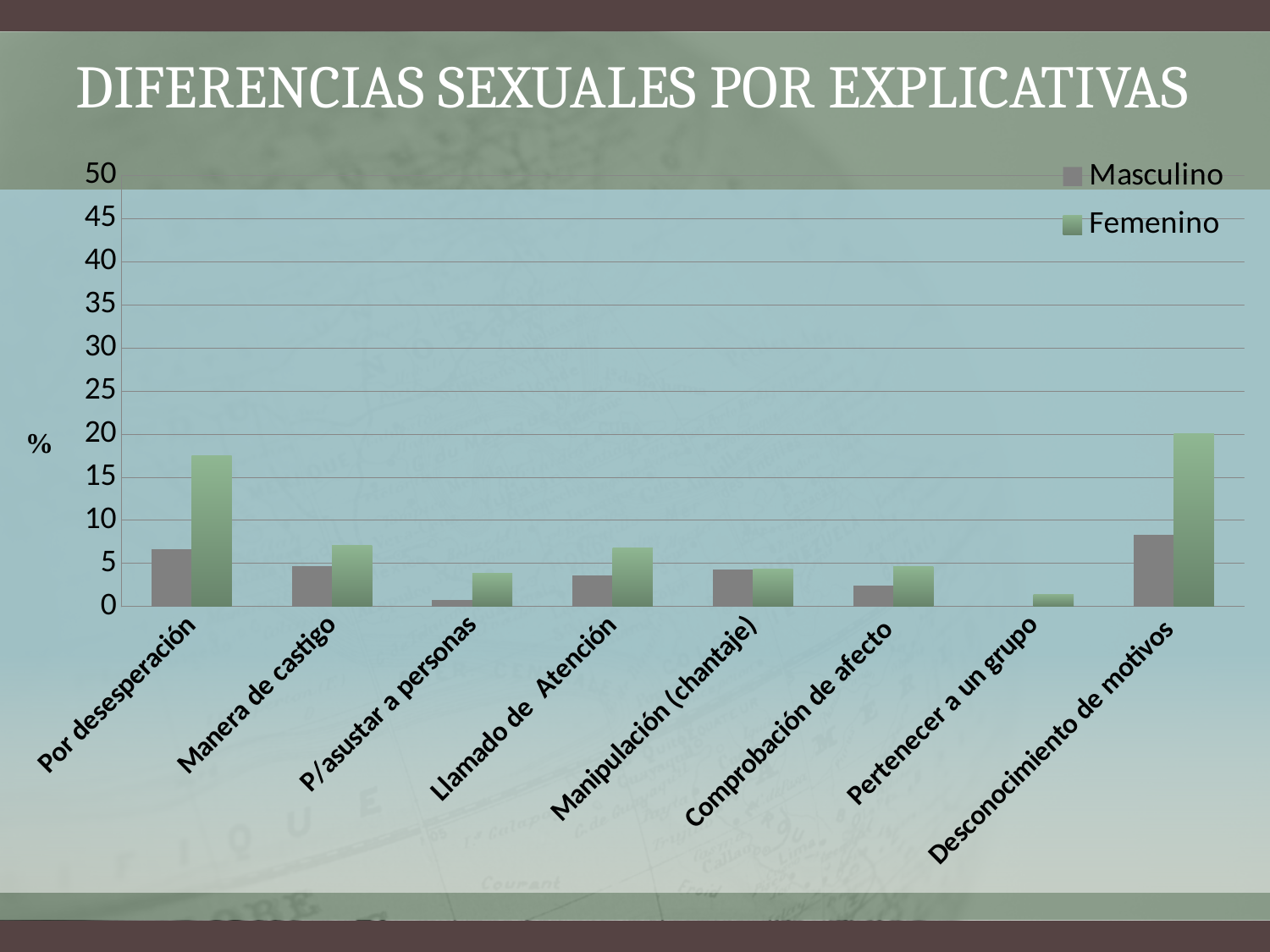
What kind of chart is shown on the slide? bar chart Which category has the lowest Femenino value? Pertenecer a un grupo Which category has the highest Masculino value? Desconocimiento de motivos Which category has the highest Femenino value? Desconocimiento de motivos What label is shown on the vertical axis? % Is the Femenino value for Pertenecer a un grupo greater or less than 5? less How many categories are shown on the x axis? 8 Is the Masculino value for Desconocimiento de motivos greater or less than 10? less How many series does the legend list? 2 What is the title of the chart? DIFERENCIAS SEXUALES POR EXPLICATIVAS For Por desesperación, which series has the larger value, Masculino or Femenino? Femenino Is the Femenino value for Por desesperación greater or less than 15? greater